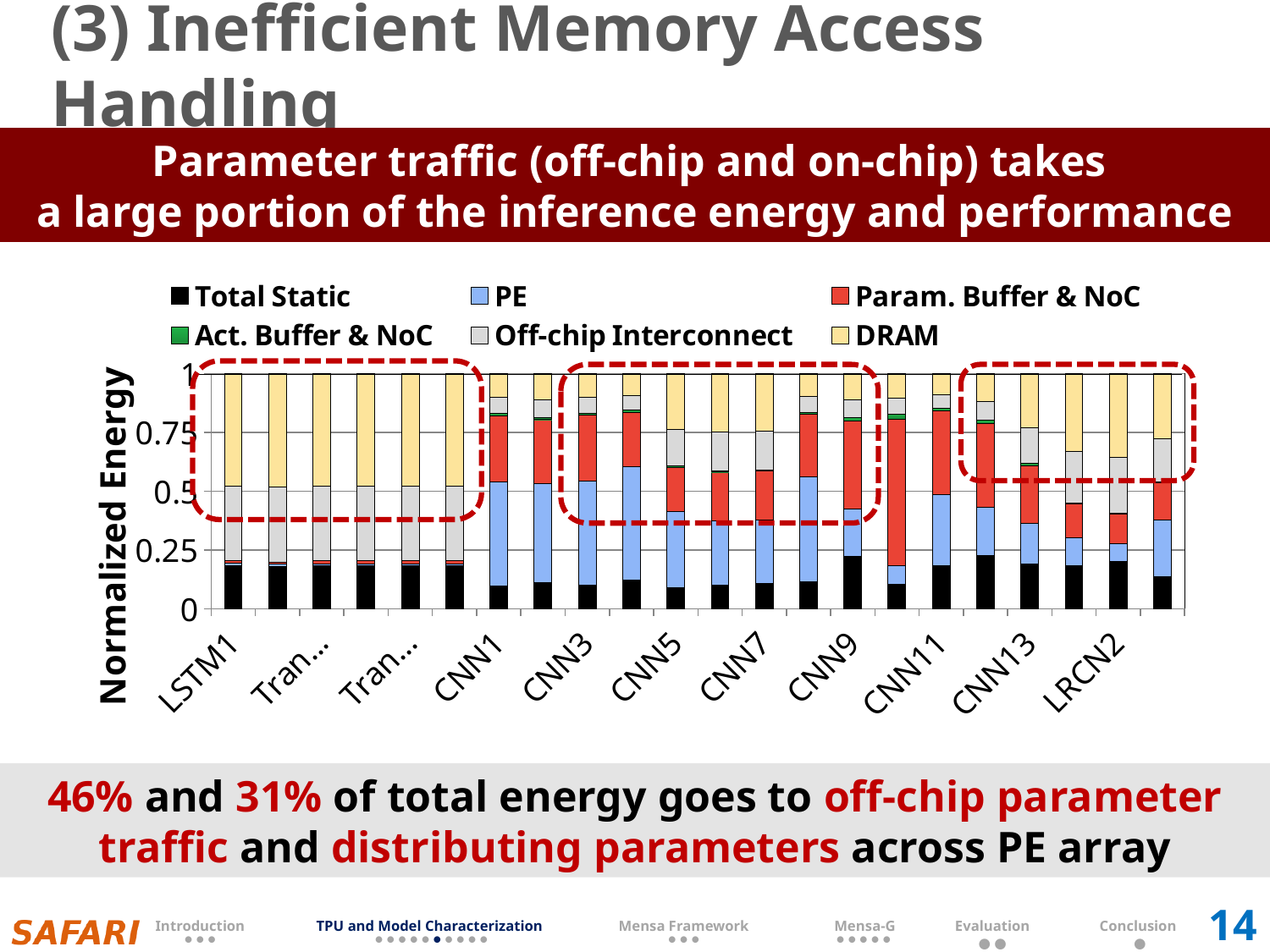
Which bar has the larger PE segment, CNN1 or LSTM1? CNN1 Which legend entry is shown in yellow? DRAM What is the highest value shown on the y axis of the chart? 1 What is the title of the y axis of the chart? Normalized Energy Which bar has the larger Total Static segment, LSTM1 or CNN1? LSTM1 Which bar has the larger DRAM segment, LSTM1 or CNN1? LSTM1 What kind of chart is shown on the slide? Stacked bar chart How many series does the legend of the chart list? 6 Is the Total Static value for LSTM1 greater or less than 0.25? less What is the total height of the CNN1 stacked bar? 1 Is the Total Static value for CNN1 greater or less than 0.25? less What is the total height of the LSTM1 stacked bar? 1